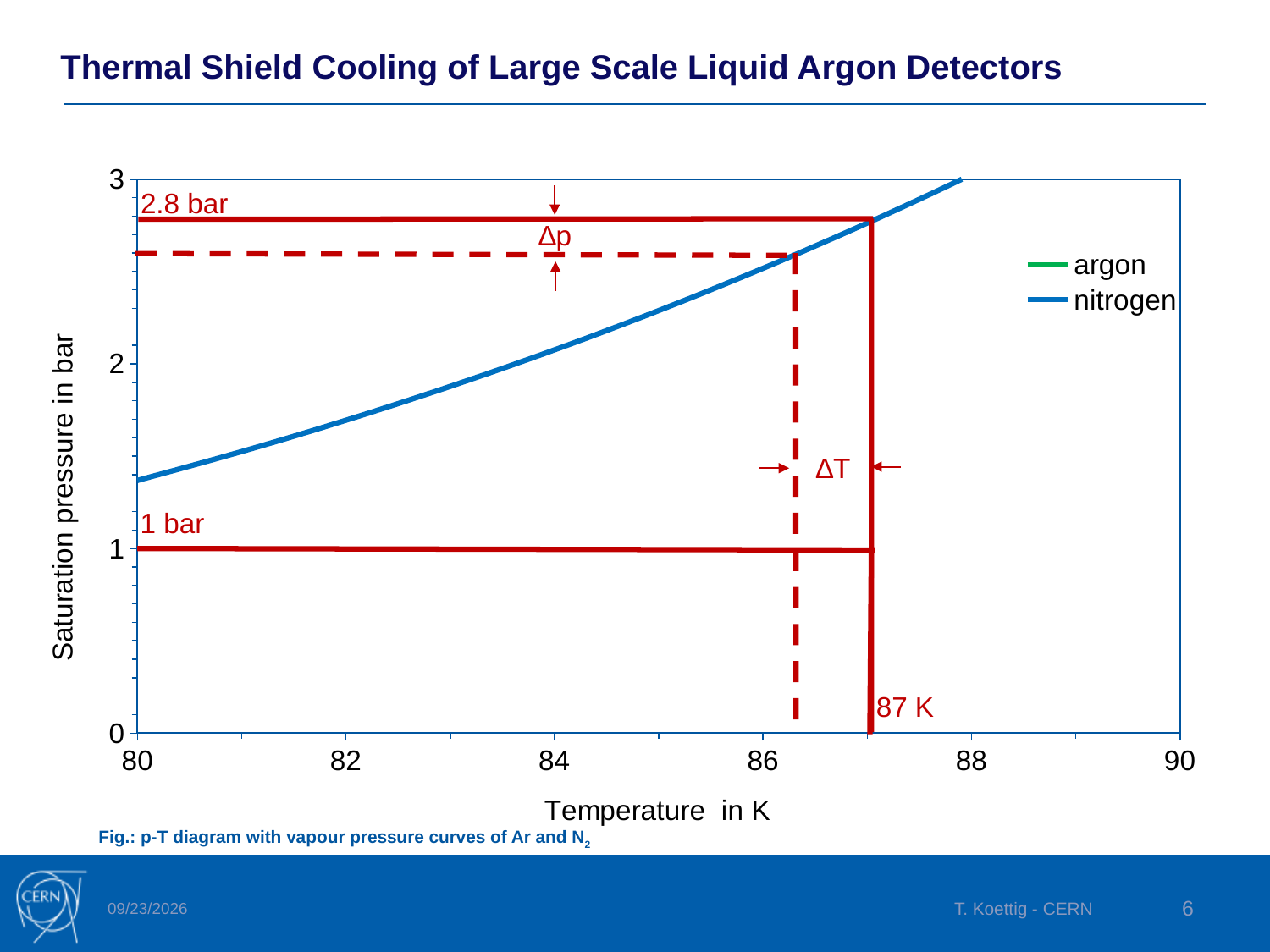
What temperature is marked by the vertical solid red line? 87 K What kind of chart is shown on the slide? line chart What pressure is marked by the upper horizontal red line? 2.8 bar What is the label of the x axis? Temperature in K Is the nitrogen saturation pressure at 82 K greater or less than 2 bar? less How many series does the legend list? 2 Is the nitrogen saturation pressure at 80 K greater or less than 1 bar? greater What is the difference between the two pressure levels marked by the red horizontal lines (2.8 bar and 1 bar)? 1.8 bar What is the label of the y axis? Saturation pressure in bar What pressure is marked by the lower horizontal red line? 1 bar Does the nitrogen saturation pressure rise or fall as temperature increases? rise Is the nitrogen saturation pressure at 86 K greater or less than 2 bar? greater